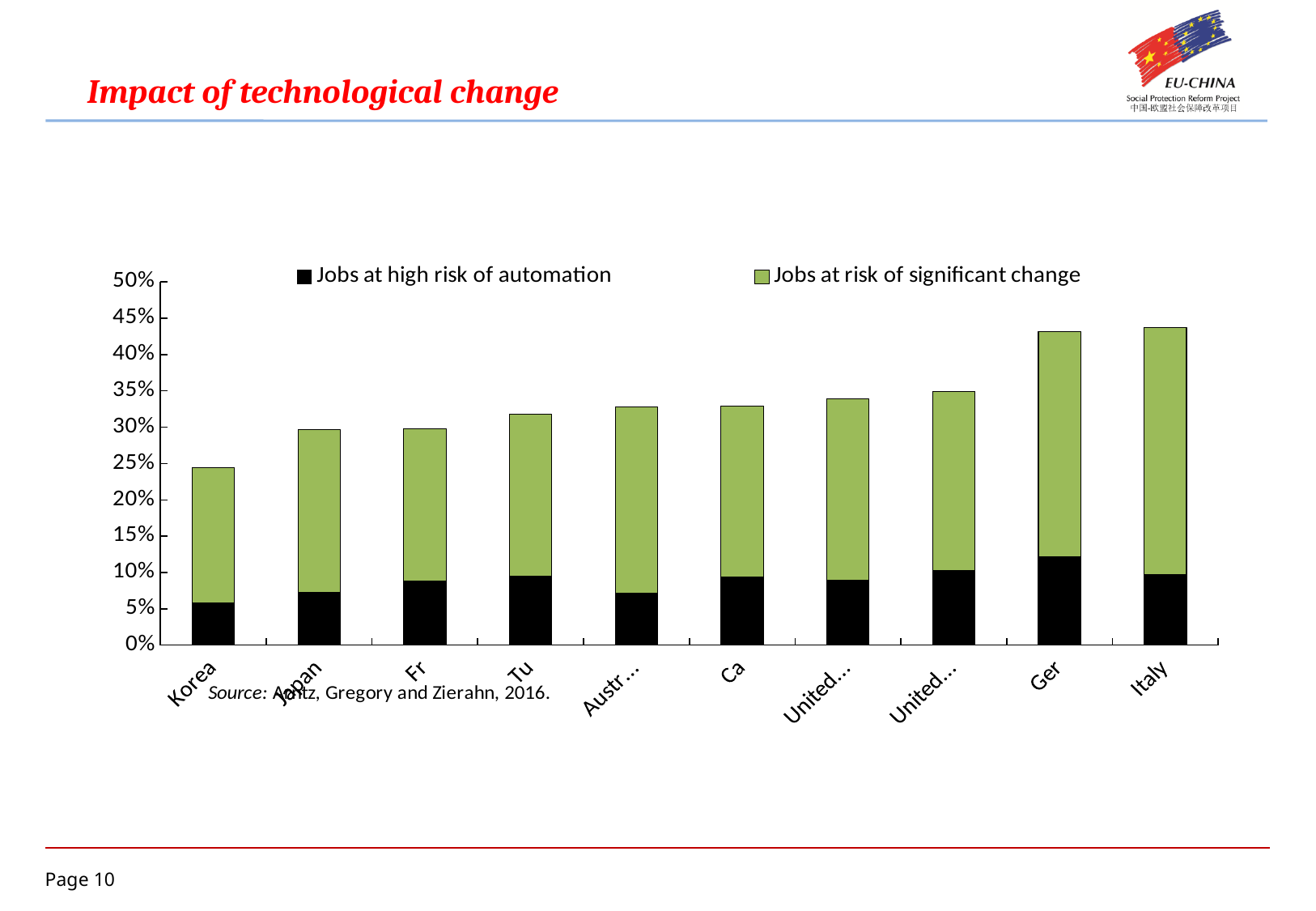
Which has the larger total bar, Korea or Japan? Japan Which country has the lowest total bar? Korea What is the source cited below the chart? Arntz, Gregory and Zierahn, 2016. What kind of chart is shown on the slide? Stacked bar chart Is the total bar for Italy greater or less than 40%? greater Do the total bar heights generally rise or fall from left to right across the chart? Rise How many series does the legend list? 2 Is the total bar for Korea greater or less than 20%? greater Is the 'Jobs at high risk of automation' value for Japan greater or less than 10%? less How many countries (bars) are shown on the chart? 10 Which series is shown in black? Jobs at high risk of automation